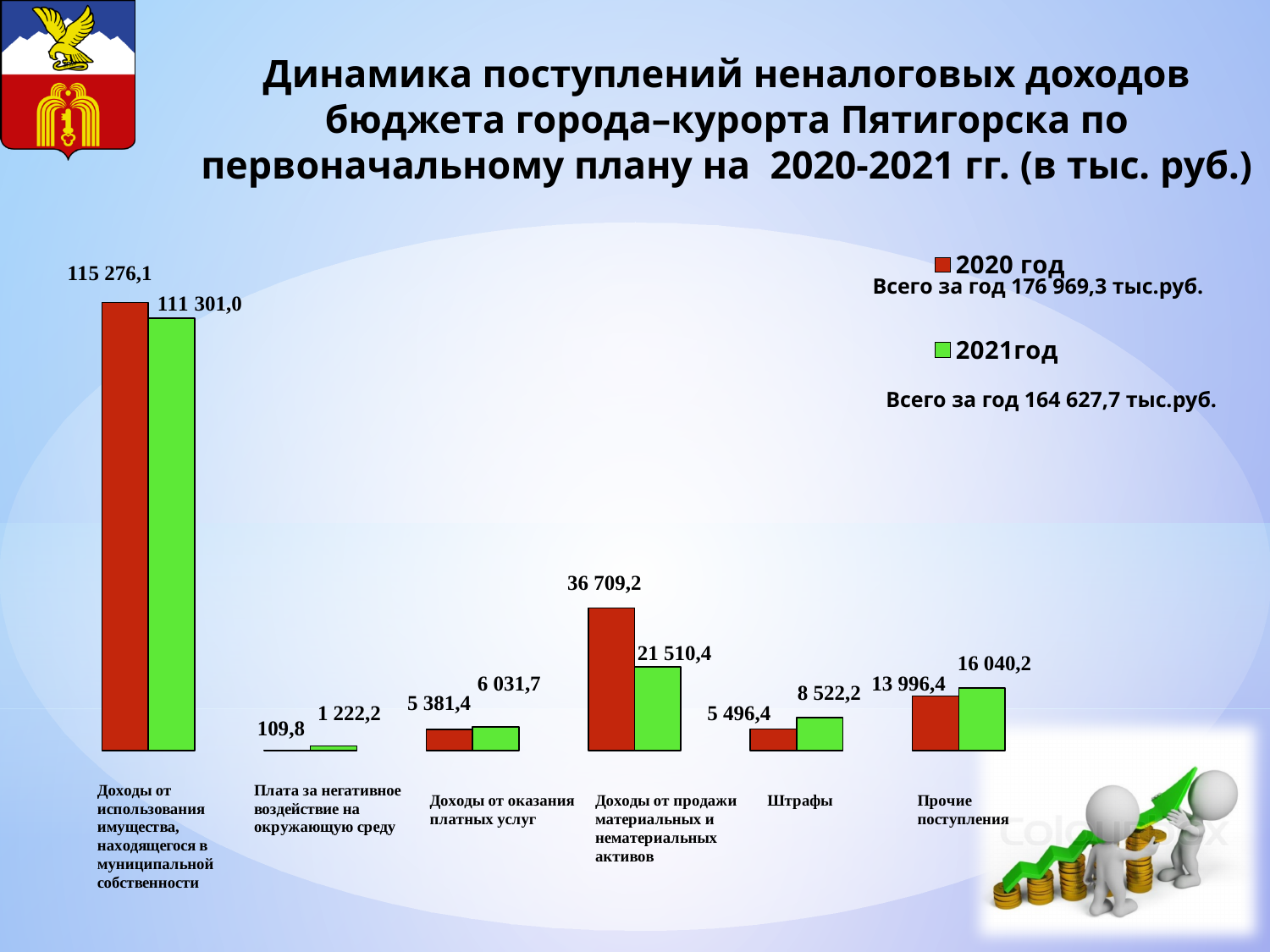
What is the value for 'Штрафы' in the '2020 год' series? 5 496,4 How many series does the legend list? 2 According to the legend text, what is the total for the year 2021 ('Всего за год')? 164 627,7 тыс.руб. What type of chart is shown on the slide? bar chart What is the value for 'Доходы от оказания платных услуг' in the '2021год' series? 6 031,7 Which category has the lowest value in the '2020 год' series? Плата за негативное воздействие на окружающую среду For 'Прочие поступления', which series has the larger value, '2020 год' or '2021год'? 2021год What is the value for 'Плата за негативное воздействие на окружающую среду' in the '2020 год' series? 109,8 How many categories are shown on the x axis of the chart? 6 What is the difference between the '2020 год' and '2021год' values for 'Доходы от продажи материальных и нематериальных активов'? 15 198,8 Which category has the highest value in the '2021год' series? Доходы от использования имущества, находящегося в муниципальной собственности What is the difference between the '2021год' and '2020 год' values for 'Штрафы'? 3 025,8